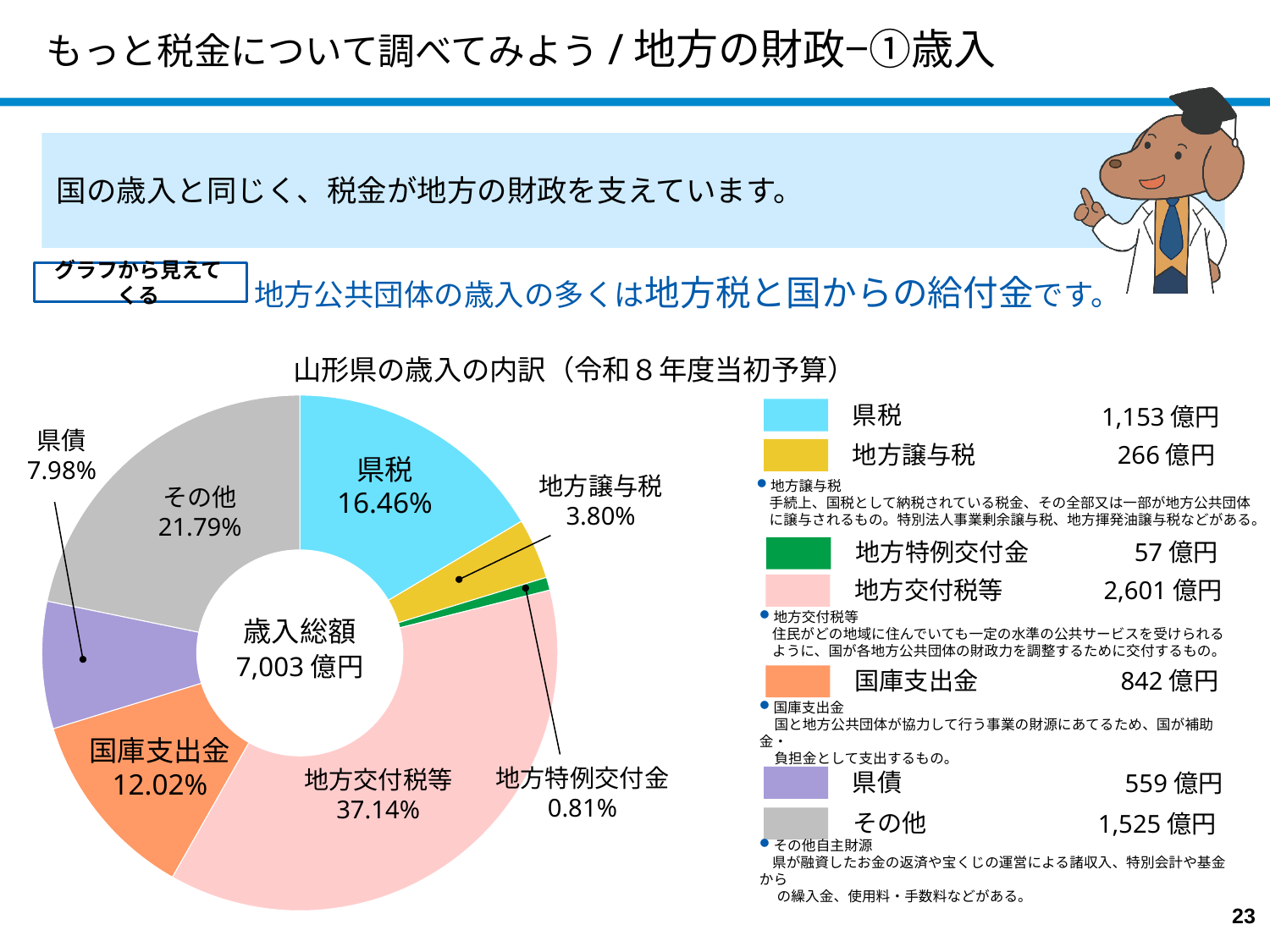
円グラフのタイトルは何ですか？ 山形県の歳入の内訳（令和８年度当初予算） 円グラフにはいくつの項目がありますか？ 7 円グラフで「県税」の割合は何%ですか？ 16.46% 凡例に示されている「国庫支出金」の金額はいくらですか？ 842 億円 「県税」と「県債」では、どちらの割合が大きいですか？ 県税 円グラフで最も割合が大きい項目はどれですか？ 地方交付税等 円グラフの中央に示されている歳入総額はいくらですか？ 7,003 億円 このグラフはどの種類のグラフですか？ 円グラフ（ドーナツグラフ） 「地方譲与税」の金額と「地方特例交付金」の金額の差はいくらですか？ 209 億円 円グラフで最も割合が小さい項目はどれですか？ 地方特例交付金 円グラフで「地方交付税等」の割合は何%ですか？ 37.14% 「その他」と「国庫支出金」の割合の差は何ポイントですか？ 9.77%